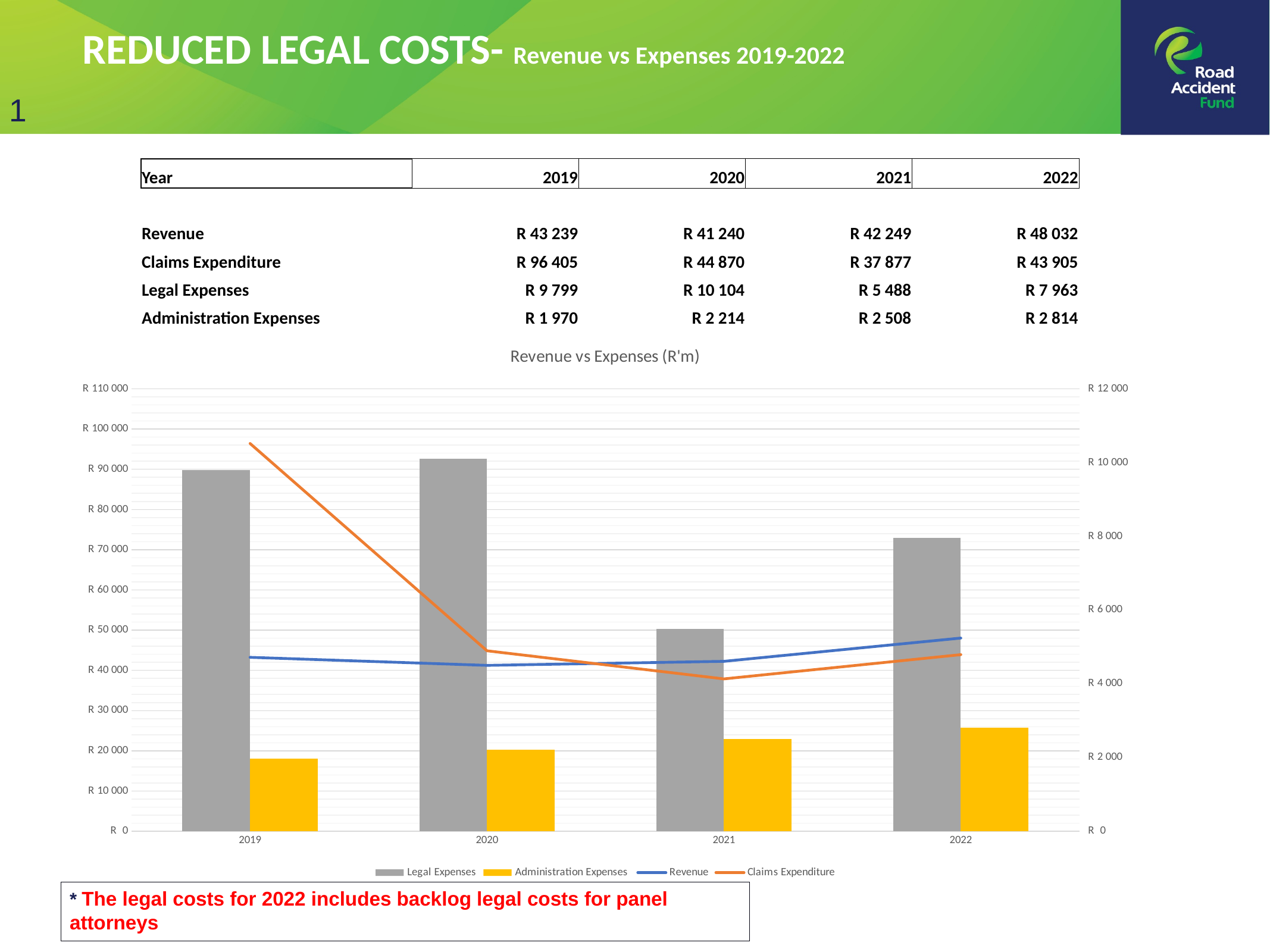
In the Revenue vs Expenses (R'm) chart, by how much did Legal Expenses fall from 2020 to 2021? R 4 616 In the Revenue vs Expenses (R'm) chart, which year has the highest Claims Expenditure? 2019 In the Revenue vs Expenses (R'm) chart, is the Administration Expenses value for 2022 greater or less than R 2 000 on the right axis? greater How many series does the legend of the Revenue vs Expenses (R'm) chart list? 4 In the Revenue vs Expenses (R'm) chart, how much higher is Revenue in 2022 than in 2019? R 4 793 In the Revenue vs Expenses (R'm) chart, which year has the lowest Legal Expenses? 2021 In the Revenue vs Expenses (R'm) chart, what is the value of Legal Expenses for 2021? R 5 488 In the Revenue vs Expenses (R'm) chart, what is the Revenue value for 2022? R 48 032 In the Revenue vs Expenses (R'm) chart, which is larger in 2019: Revenue or Claims Expenditure? Claims Expenditure How many years are shown on the x axis of the Revenue vs Expenses (R'm) chart? 4 What kind of chart is the Revenue vs Expenses (R'm) chart? Combination bar and line chart In the Revenue vs Expenses (R'm) chart, do Administration Expenses rise or fall from 2019 to 2022? Rise